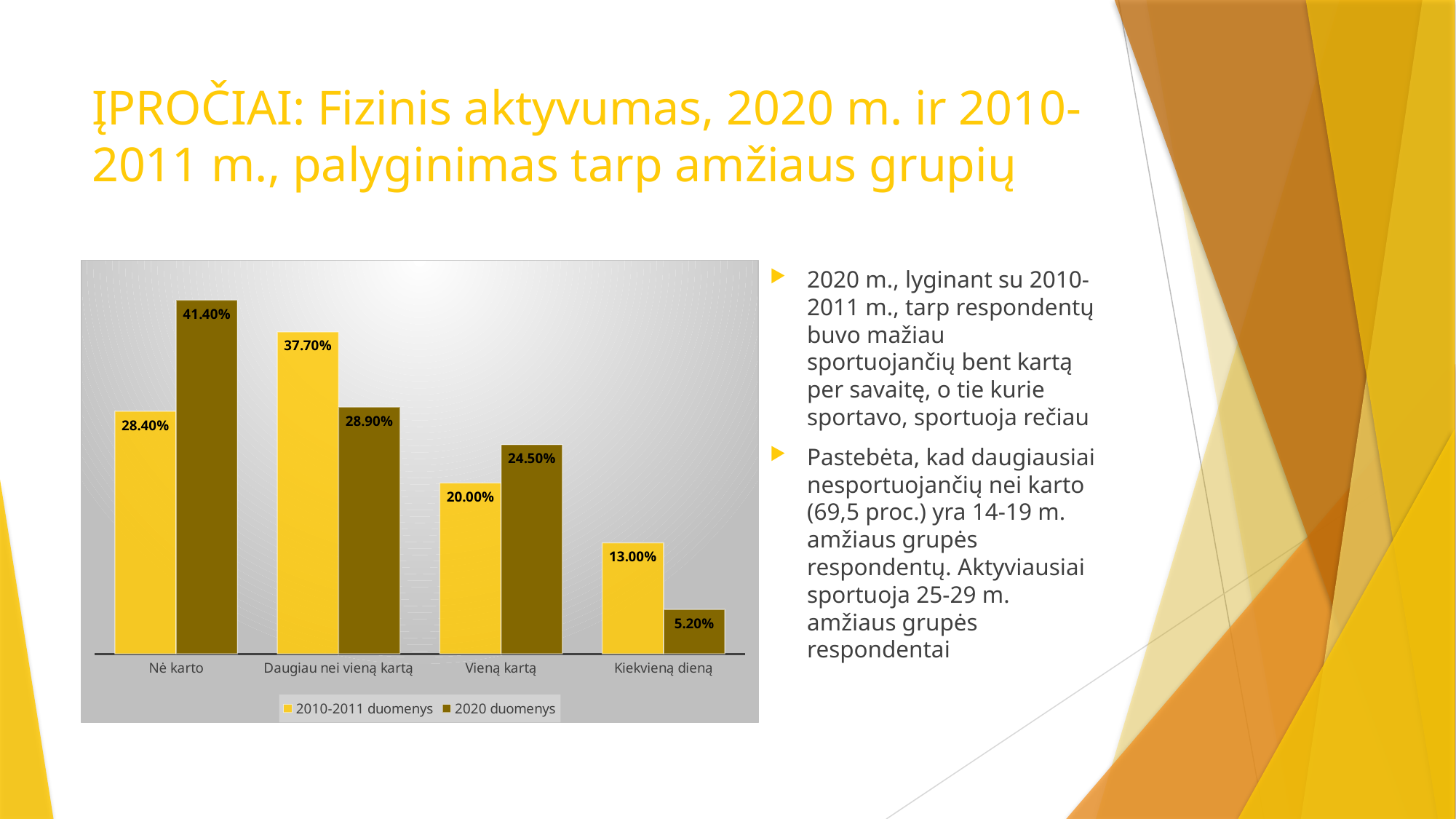
Which category has the highest value in the 2020 duomenys series? Nė karto For "Vieną kartą", which series has the larger value: 2010-2011 duomenys or 2020 duomenys? 2020 duomenys What is the difference between the 2010-2011 duomenys and 2020 duomenys values for "Kiekvieną dieną"? 7.80% How many series does the chart legend list? 2 What is the value for "Vieną kartą" in the 2010-2011 duomenys series? 20.00% What is the value for "Kiekvieną dieną" in the 2020 duomenys series? 5.20% What is the difference between the 2020 duomenys and 2010-2011 duomenys values for "Nė karto"? 13.00% Which category has the lowest value in the 2010-2011 duomenys series? Kiekvieną dieną What is the value for "Nė karto" in the 2020 duomenys series? 41.40% What kind of chart is shown on the slide? Bar chart How many categories are shown on the x axis of the chart? 4 What is the value for "Daugiau nei vieną kartą" in the 2010-2011 duomenys series? 37.70%